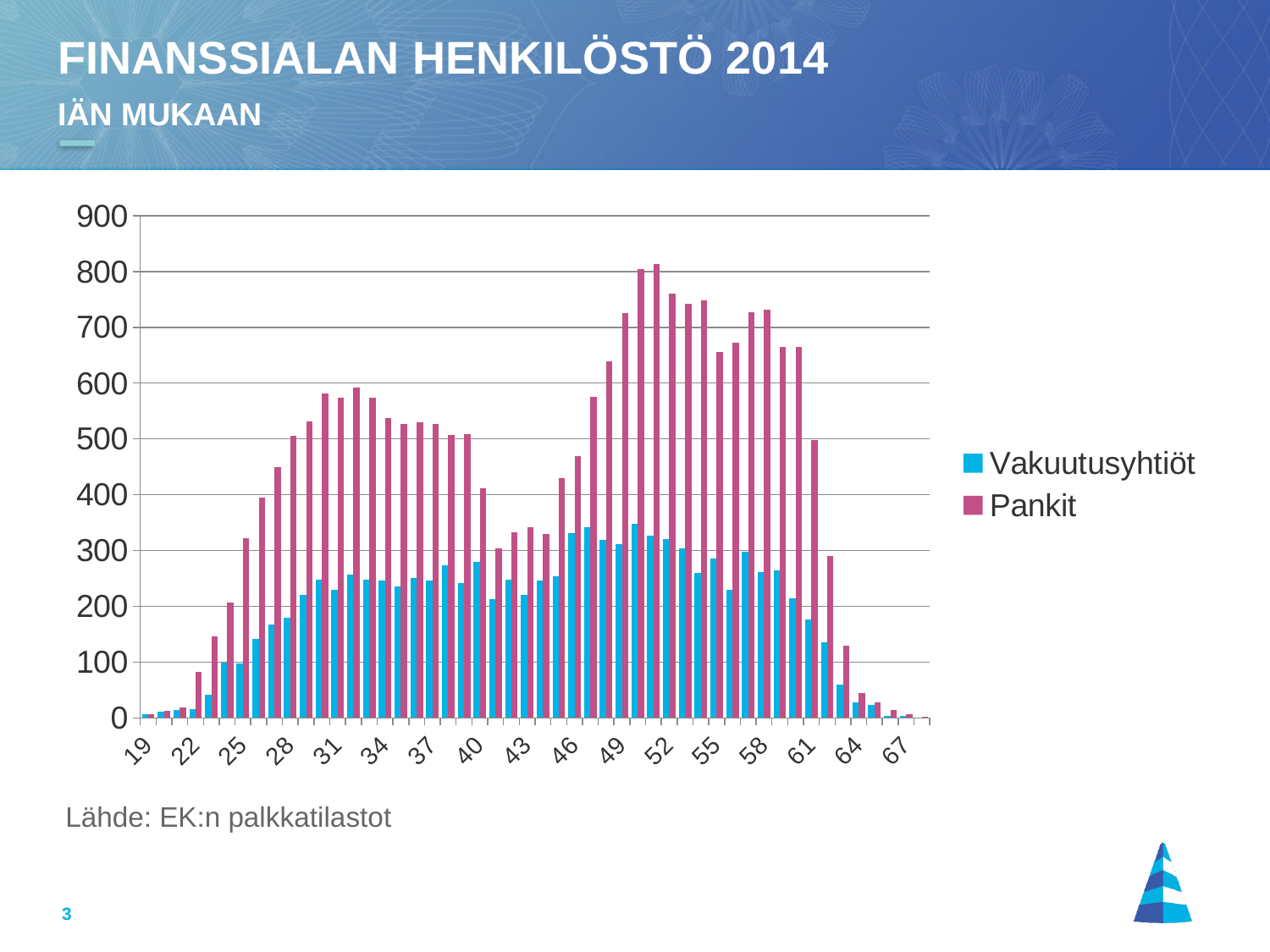
How many series does the legend list? 2 Do the Pankit values rise or fall from age 19 to age 31? Rise Is the Vakuutusyhtiöt value at age 25 greater or less than 200? less What are the two series named in the legend? Vakuutusyhtiöt and Pankit At age 52, which series has the larger value, Vakuutusyhtiöt or Pankit? Pankit Is the Vakuutusyhtiöt value at age 34 greater or less than 300? less Is the Pankit value at age 61 greater or less than 400? greater Do the Pankit values rise or fall from age 52 to age 67? Fall What is the title of the chart slide? FINANSSIALAN HENKILÖSTÖ 2014 What kind of chart is shown on the slide? Bar chart